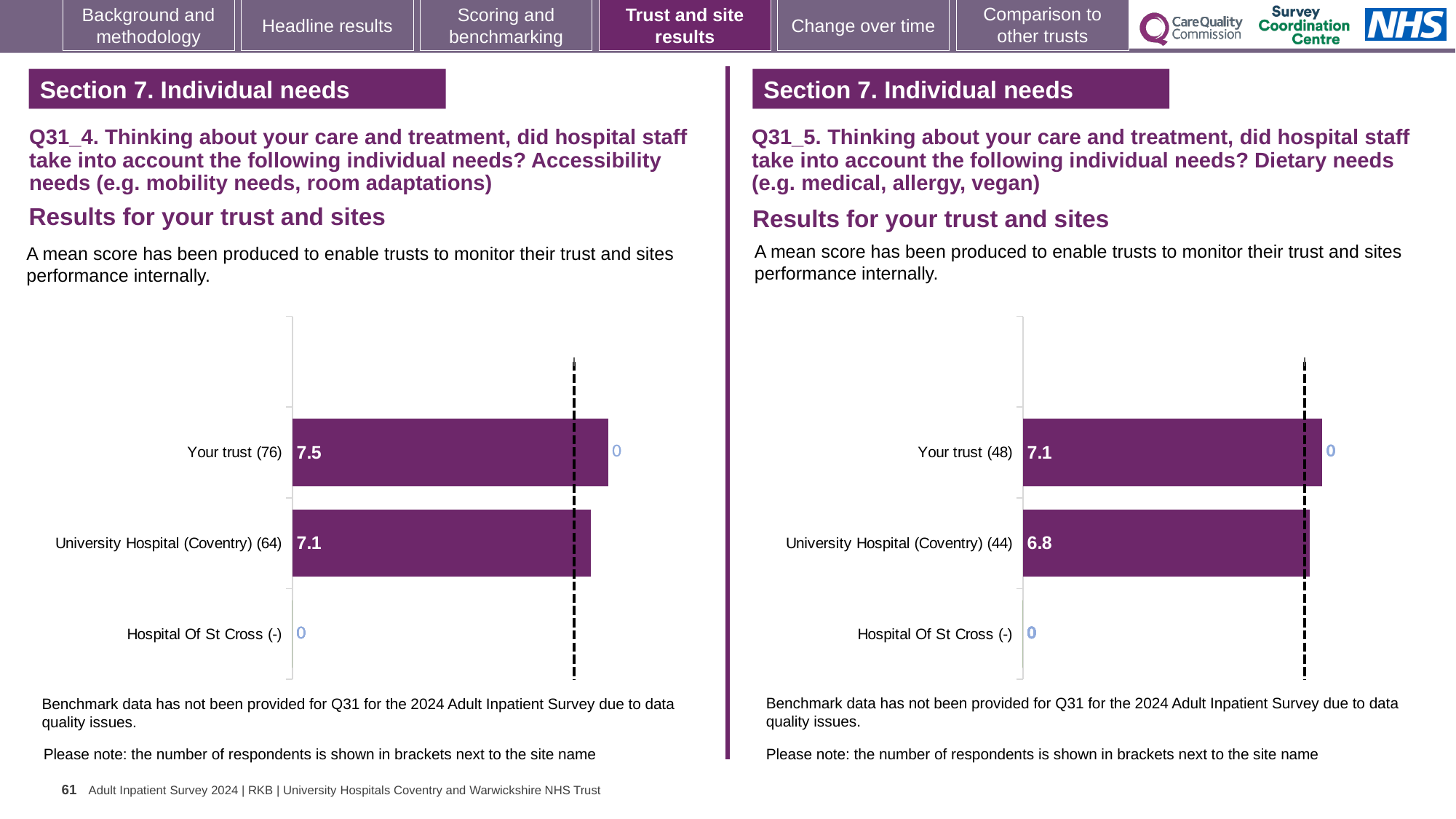
In the right chart (Q31_5, Dietary needs), which has the higher score: Your trust or University Hospital (Coventry)? Your trust What kind of chart is used on the right side of the slide (Q31_5, Dietary needs)? Bar chart In the right chart (Q31_5, Dietary needs), what is the difference between the scores for Your trust and University Hospital (Coventry)? 0.3 In the left chart (Q31_4, Accessibility needs), what is the mean score for Your trust? 7.5 How many categories are listed on the y axis of the left chart (Q31_4, Accessibility needs)? 3 In the left chart (Q31_4, Accessibility needs), which category has the highest score? Your trust In the right chart (Q31_5, Dietary needs), what is the mean score for University Hospital (Coventry)? 6.8 In the left chart (Q31_4, Accessibility needs), what is the difference between the scores for Your trust and University Hospital (Coventry)? 0.4 In the left chart (Q31_4, Accessibility needs), how many respondents are shown in brackets for Your trust? 76 In the right chart (Q31_5, Dietary needs), what is the mean score for Your trust? 7.1 In the left chart (Q31_4, Accessibility needs), what is the mean score for University Hospital (Coventry)? 7.1 In the right chart (Q31_5, Dietary needs), how many respondents are shown in brackets for University Hospital (Coventry)? 44